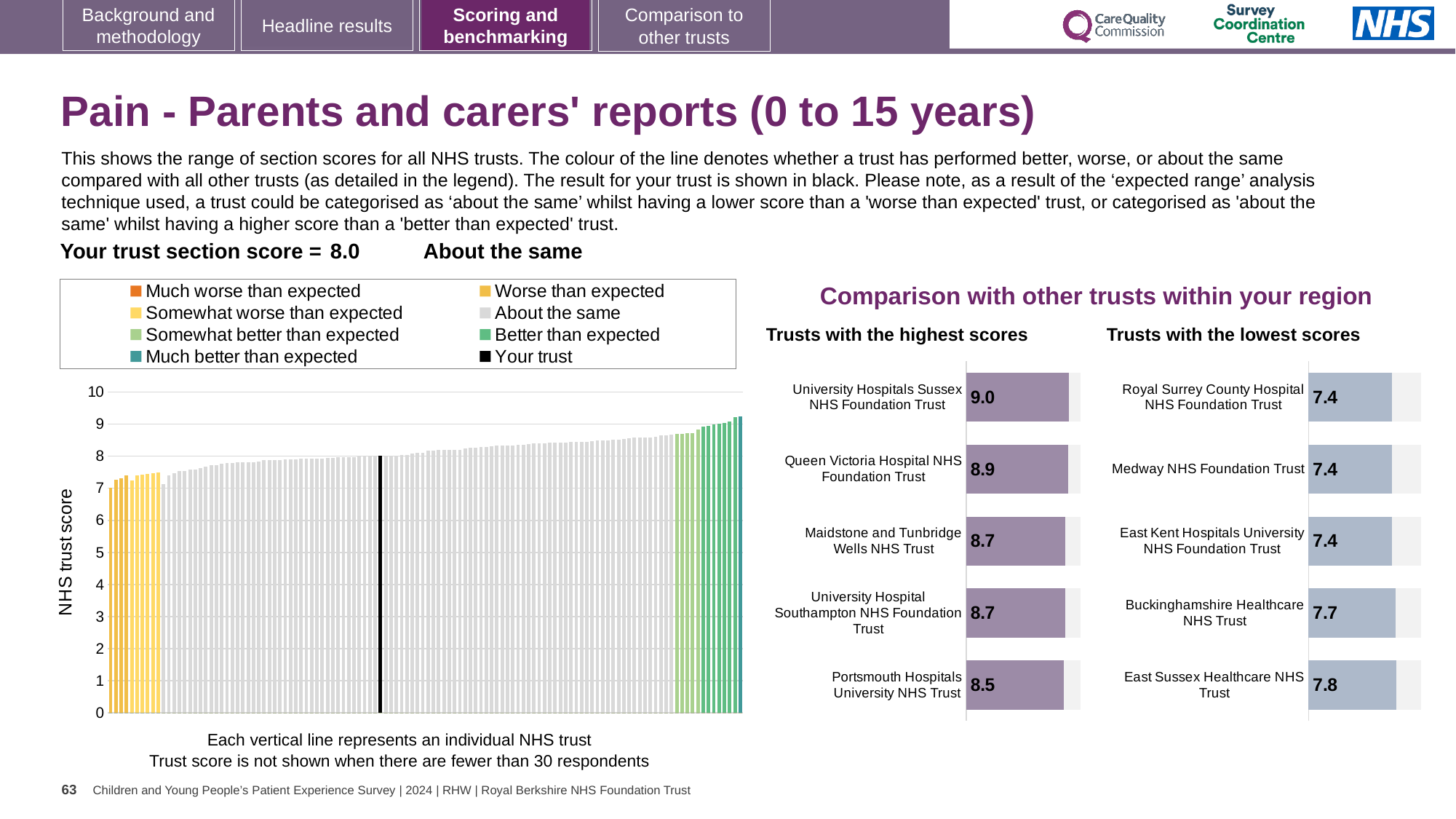
In the main chart on the left, is the value of the tallest bar greater or less than 9? greater In the 'Trusts with the highest scores' chart, how many trusts are shown? 5 In the 'Trusts with the highest scores' chart, what is the score for Queen Victoria Hospital NHS Foundation Trust? 8.9 In the 'Trusts with the lowest scores' chart, what is the score for Buckinghamshire Healthcare NHS Trust? 7.7 In the 'Trusts with the highest scores' chart, which trust has the highest score? University Hospitals Sussex NHS Foundation Trust In the 'Trusts with the highest scores' chart, what is the difference between the scores of University Hospitals Sussex NHS Foundation Trust and Portsmouth Hospitals University NHS Trust? 0.5 In the main chart on the left, what is the section score for your trust (the black bar)? 8.0 How many entries does the legend above the main chart on the left list? 8 In the main chart on the left, what is the label on the vertical axis? NHS trust score What kind of chart is the main chart on the left showing all NHS trusts? bar chart In the 'Trusts with the lowest scores' chart, which has the larger score: Buckinghamshire Healthcare NHS Trust or East Sussex Healthcare NHS Trust? East Sussex Healthcare NHS Trust In the 'Trusts with the lowest scores' chart, which trust has the highest score? East Sussex Healthcare NHS Trust